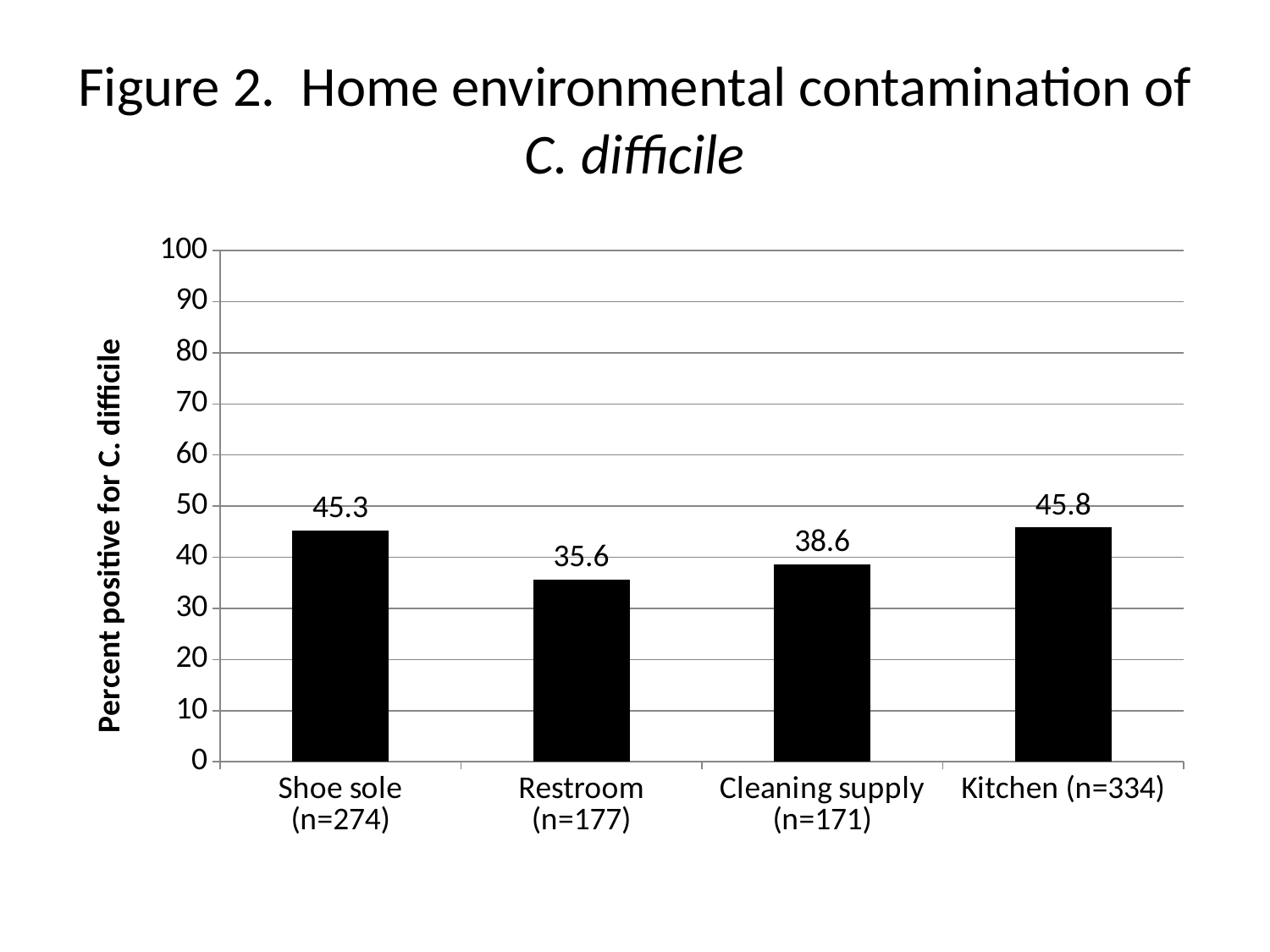
What is the difference in percent positive between Shoe sole (n=274) and Cleaning supply (n=171)? 6.7 What is the difference in percent positive between Kitchen (n=334) and Restroom (n=177)? 10.2 Which has a higher percent positive for C. difficile, Shoe sole (n=274) or Restroom (n=177)? Shoe sole (n=274) What is the percent positive for C. difficile for Cleaning supply (n=171)? 38.6 Which category has the lowest percent positive for C. difficile? Restroom (n=177) How many categories are shown on the chart? 4 What is the label of the vertical axis? Percent positive for C. difficile What is the percent positive for C. difficile for Restroom (n=177)? 35.6 What kind of chart is shown on the slide? bar chart What is the percent positive for C. difficile for Shoe sole (n=274)? 45.3 Is the value for Cleaning supply (n=171) greater or less than 50? less What is the percent positive for C. difficile for Kitchen (n=334)? 45.8